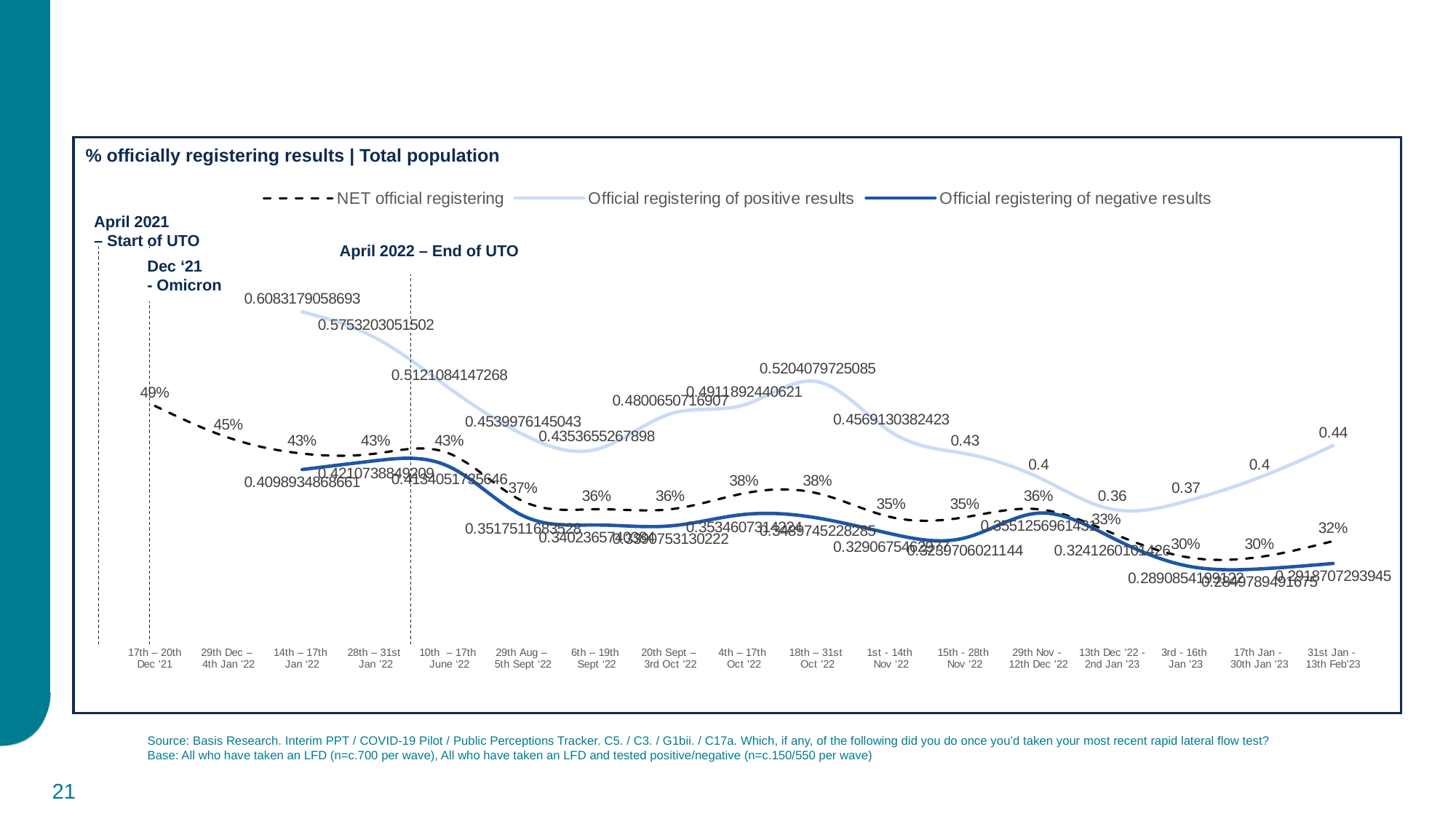
Does the NET official registering value rise or fall from 17th – 20th Dec '21 to 28th – 31st Jan '22? Fall In which period is the NET official registering value highest? 17th – 20th Dec '21 How many time periods are shown on the x axis? 17 What is the Official registering of positive results value for 31st Jan - 13th Feb '23? 0.44 Which period has the higher NET official registering value: 4th – 17th Oct '22 or 1st - 14th Nov '22? 4th – 17th Oct '22 What kind of chart is shown on the slide? Line chart How many series does the legend list? 3 In which period is the Official registering of positive results value highest? 14th – 17th Jan '22 What is the difference between the NET official registering values for 17th – 20th Dec '21 and 31st Jan - 13th Feb '23? 17 percentage points What is the NET official registering value for 17th – 20th Dec '21? 49% What is the Official registering of positive results value for 14th – 17th Jan '22? 0.6083179058693 What is the NET official registering value for 31st Jan - 13th Feb '23? 32%